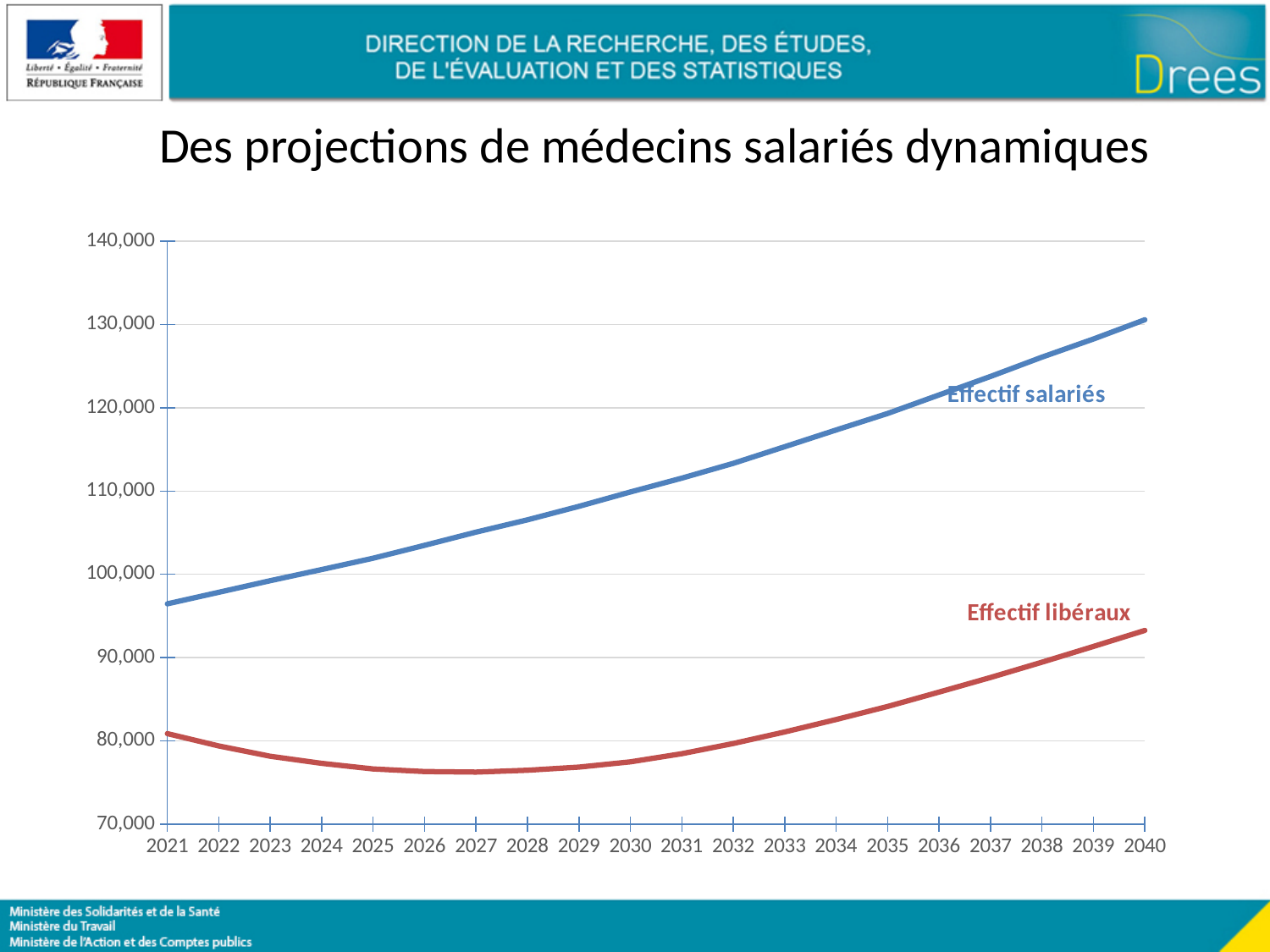
Does the Effectif libéraux series rise or fall from 2030 to 2040? rise In 2040, which series has the larger value, Effectif salariés or Effectif libéraux? Effectif salariés What kind of chart is shown on the slide? line chart Is the value for Effectif libéraux in 2027 greater or less than 80,000? less What is the title of the slide containing the chart? Des projections de médecins salariés dynamiques In which year is the Effectif salariés series at its highest? 2040 How many series are plotted on the chart? 2 What is the first year shown on the x axis? 2021 In which year is the Effectif salariés series at its lowest? 2021 How many years are shown along the x axis of the chart? 20 Is the value for Effectif salariés in 2021 greater or less than 100,000? less Does the Effectif salariés series rise or fall from 2021 to 2040? rise